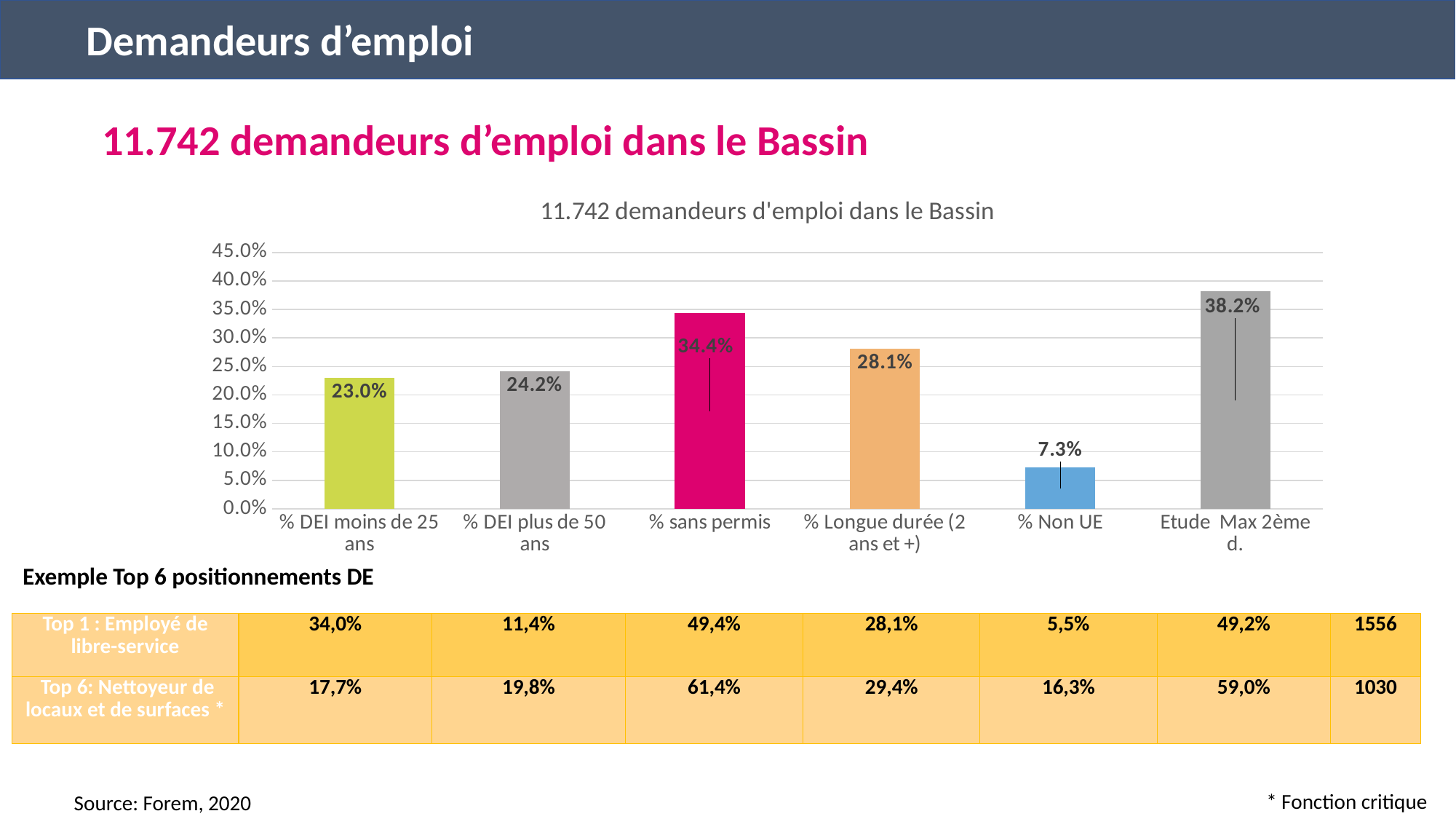
What is the value for "% sans permis"? 34.4% What is the difference between "% sans permis" and "% Longue durée (2 ans et +)"? 6.3% Which category has the highest value? Etude Max 2ème d. What is the title of the chart? 11.742 demandeurs d'emploi dans le Bassin What is the value for "Etude Max 2ème d."? 38.2% What is the value for "% Non UE"? 7.3% Which category has the lowest value? % Non UE Is the value for "% Longue durée (2 ans et +)" greater or less than 25.0%? greater What is the value for "% DEI moins de 25 ans"? 23.0% How many categories are shown on the chart? 6 What kind of chart is shown? Bar chart Which is larger, "% DEI plus de 50 ans" or "% DEI moins de 25 ans"? % DEI plus de 50 ans